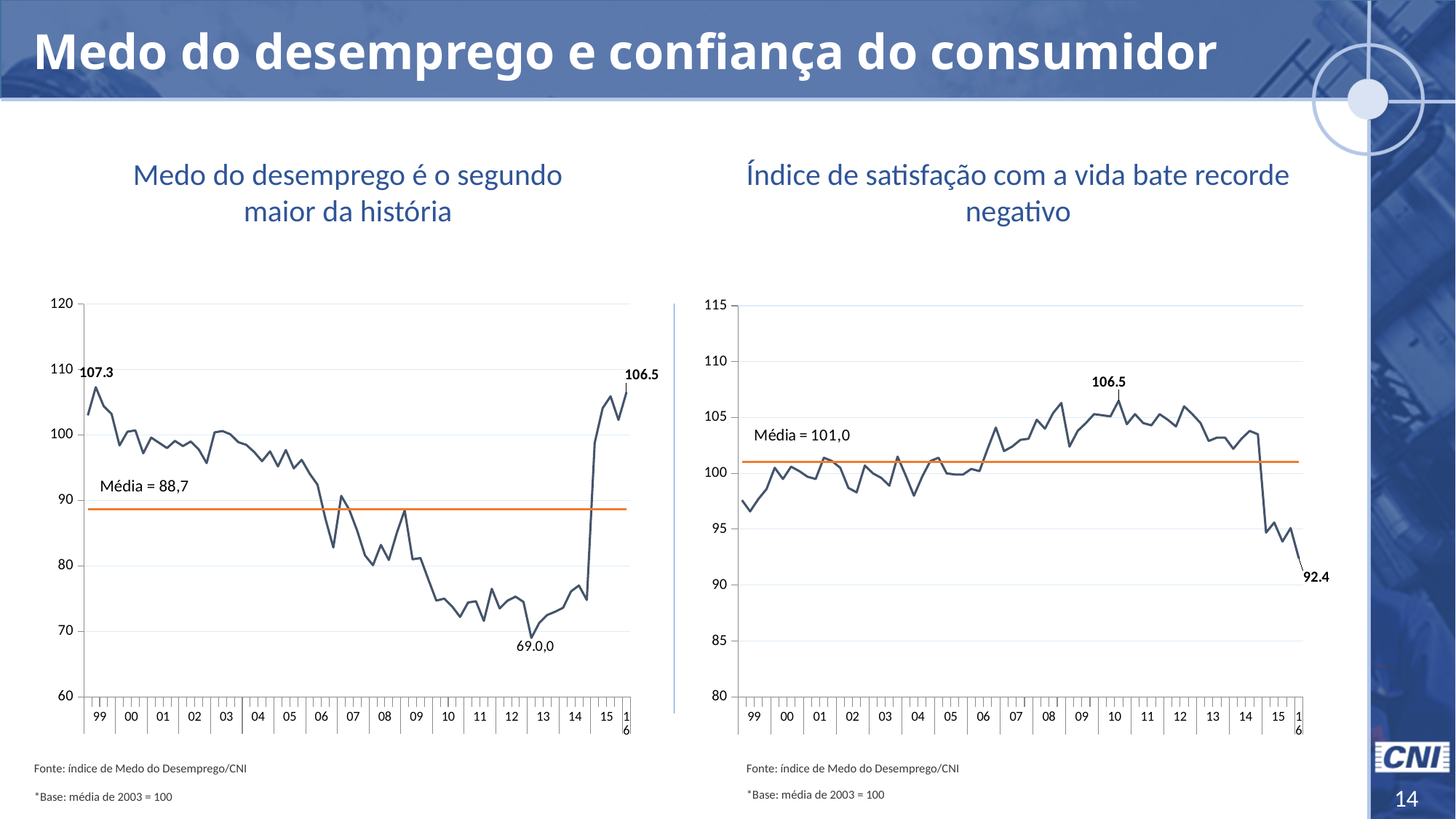
In the right chart, does the line rise or fall between 14 and 16? fall In the right chart, is the value at the end of the series in 16 greater or less than 95? less In the right chart, what average value does the horizontal orange line represent? Média = 101,0 In the left chart, what average value does the horizontal orange line represent? Média = 88,7 In the left chart, is the value at the end of the series in 16 greater or less than 100? greater What kind of chart is the right chart, 'Índice de satisfação com a vida bate recorde negativo'? line chart In the left chart, what is the value of the last labelled point in 16? 106.5 In the right chart, what is the value of the last labelled point in 16? 92.4 In the left chart, what is the value of the first labelled point at the start of the series in 99? 107.3 In the right chart, what is the value of the labelled peak around 10? 106.5 What kind of chart is the left chart, 'Medo do desemprego é o segundo maior da história'? line chart In the left chart, what is the lowest labelled value on the line? 69.0,0